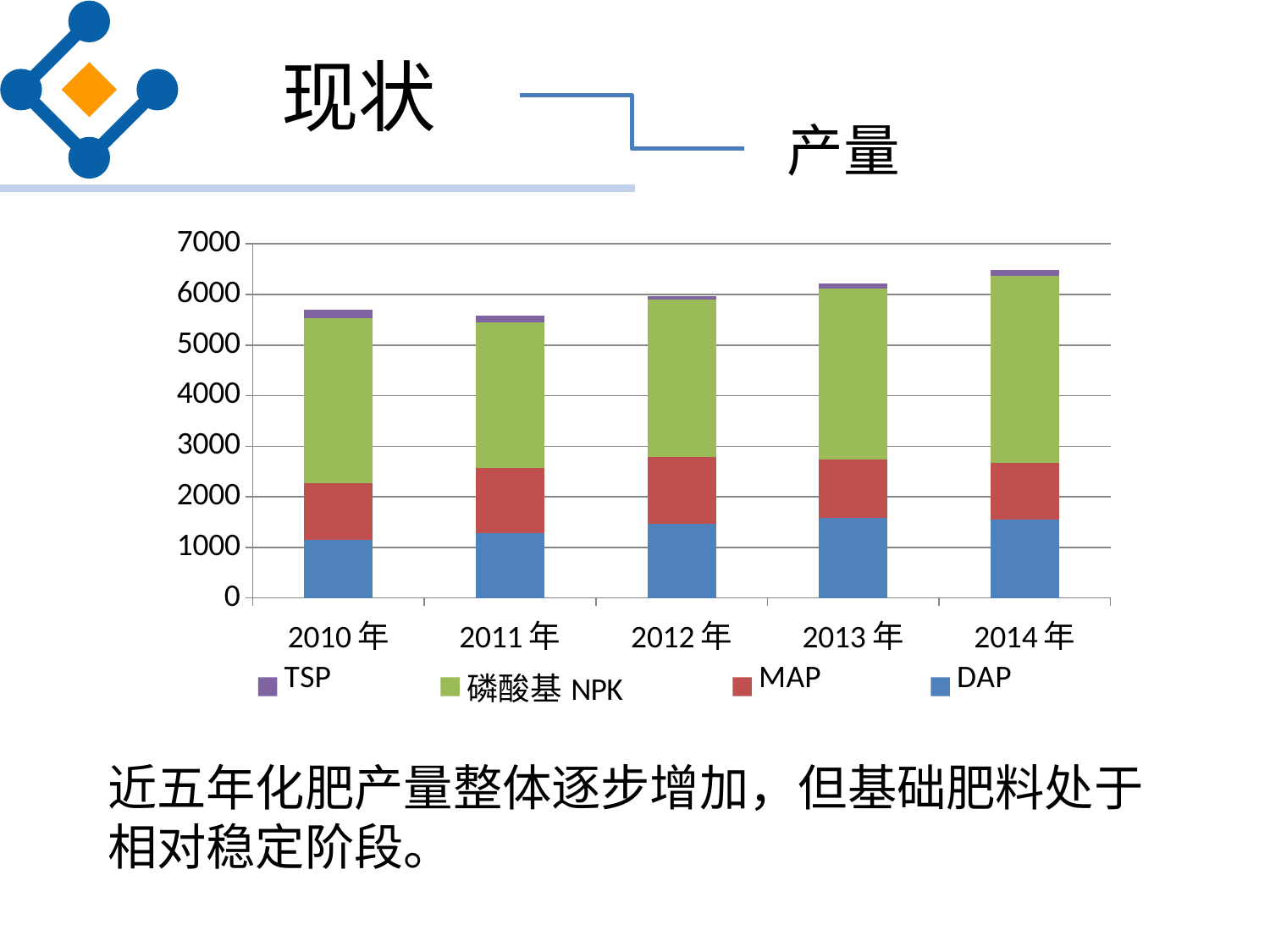
Which is larger, the DAP value for 2013 年 or the DAP value for 2010 年? 2013 年 Do the total bar heights rise or fall from 2011 年 to 2014 年? rise Which series forms the largest segment of each stacked bar? 磷酸基 NPK Is the DAP value for 2010 年 greater or less than 1000? greater What kind of chart is shown on the slide? stacked bar chart Which year has the highest total stacked bar? 2014 年 Which series forms the smallest segment of each stacked bar? TSP How many years are shown on the x axis of the chart? 5 Is the total bar for 2010 年 greater or less than 6000? less Is the total bar for 2014 年 greater or less than 6000? greater How many series does the chart legend list? 4